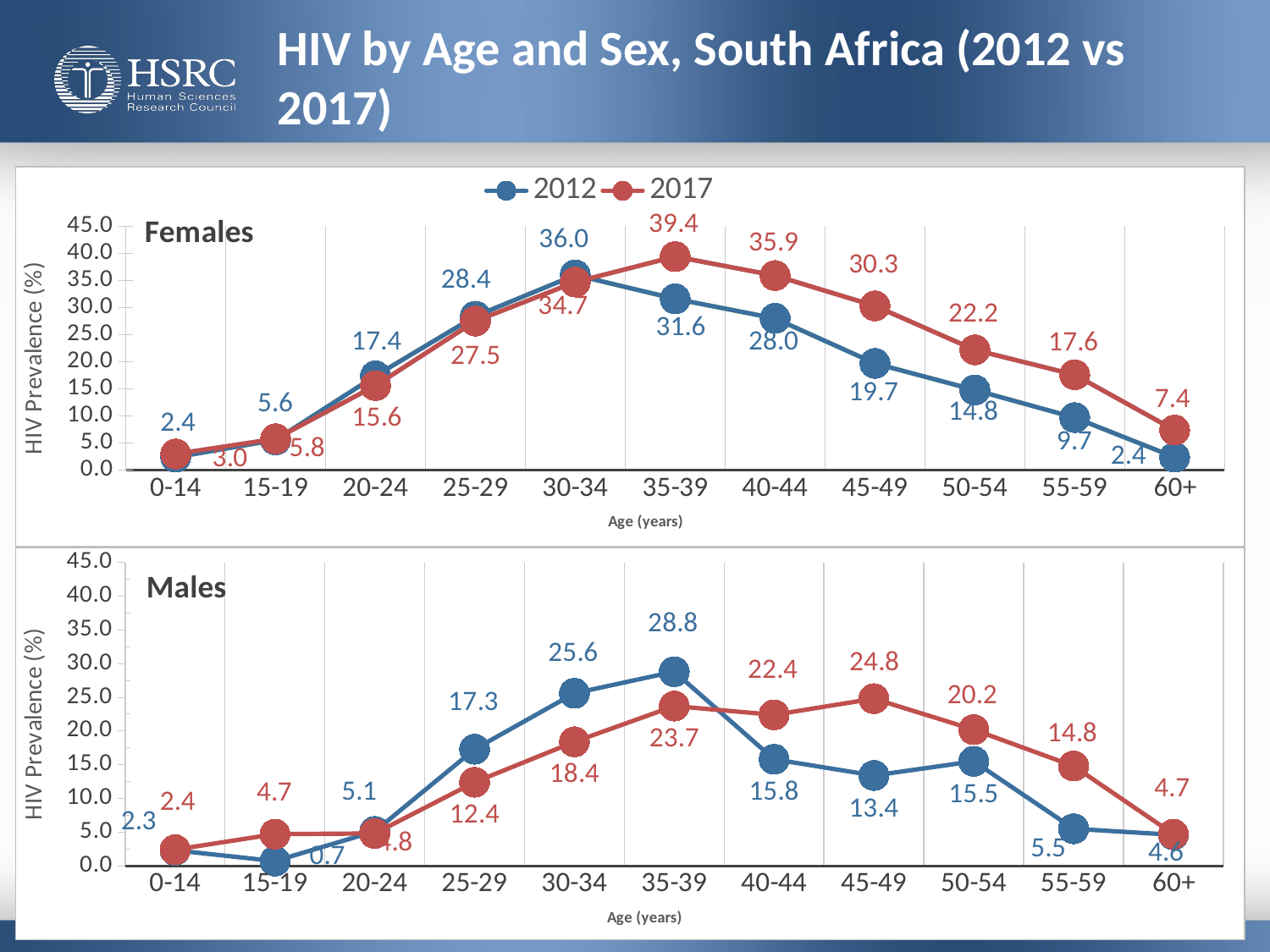
In the Females chart, what is the HIV prevalence for 2017 in the 35-39 age group? 39.4 In the Males chart, which age group has the highest 2012 HIV prevalence? 35-39 How many age groups are shown on the x axis of the Males chart? 11 In the Females chart, what is the HIV prevalence for 2012 in the 30-34 age group? 36.0 In the Males chart, which age group has the lowest 2012 HIV prevalence? 15-19 How many series does the legend list? 2 In the Females chart, which age group has the highest 2017 HIV prevalence? 35-39 In the Males chart, what is the HIV prevalence for 2017 in the 45-49 age group? 24.8 In the Females chart, is the 2017 value for the 50-54 age group greater or less than 20.0? greater What kind of chart is the Females chart? Line chart In the Females chart, what is the difference between the 2017 and 2012 values for the 45-49 age group? 10.6 In the Males chart, which is larger for the 40-44 age group, the 2012 value or the 2017 value? 2017